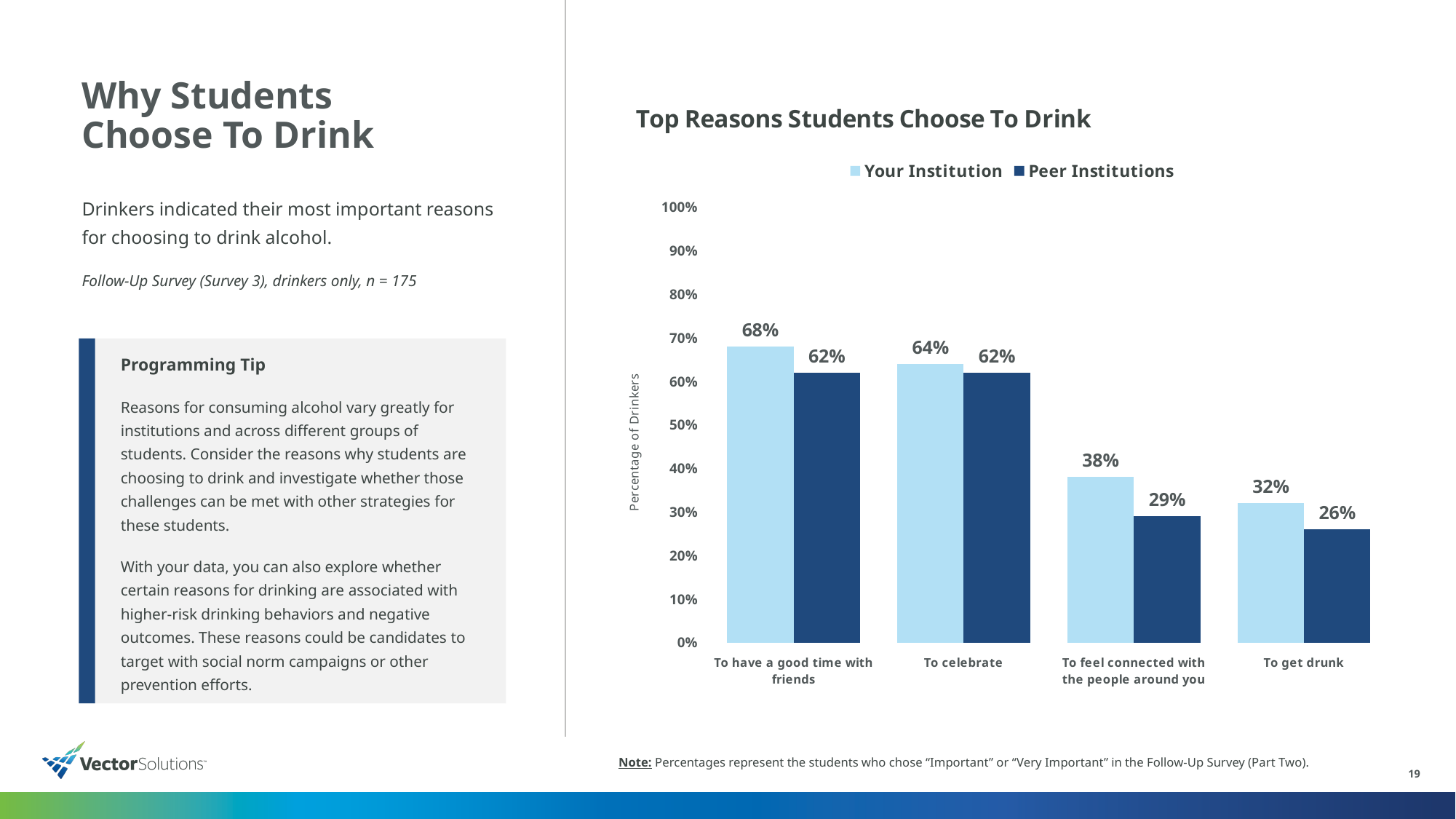
What is the title of the chart? Top Reasons Students Choose To Drink What kind of chart is shown? Bar chart For "To celebrate", which is larger: Your Institution or Peer Institutions? Your Institution Which category has the lowest value for Peer Institutions? To get drunk How many series does the legend list? 2 How many categories are shown on the x axis? 4 What is the value for Your Institution for "To get drunk"? 32% Is the Peer Institutions value for "To get drunk" greater or less than 30%? less Which category has the highest value for Your Institution? To have a good time with friends What is the value for Your Institution for "To have a good time with friends"? 68% What is the value for Peer Institutions for "To feel connected with the people around you"? 29% What is the difference between Your Institution and Peer Institutions for "To feel connected with the people around you"? 9%